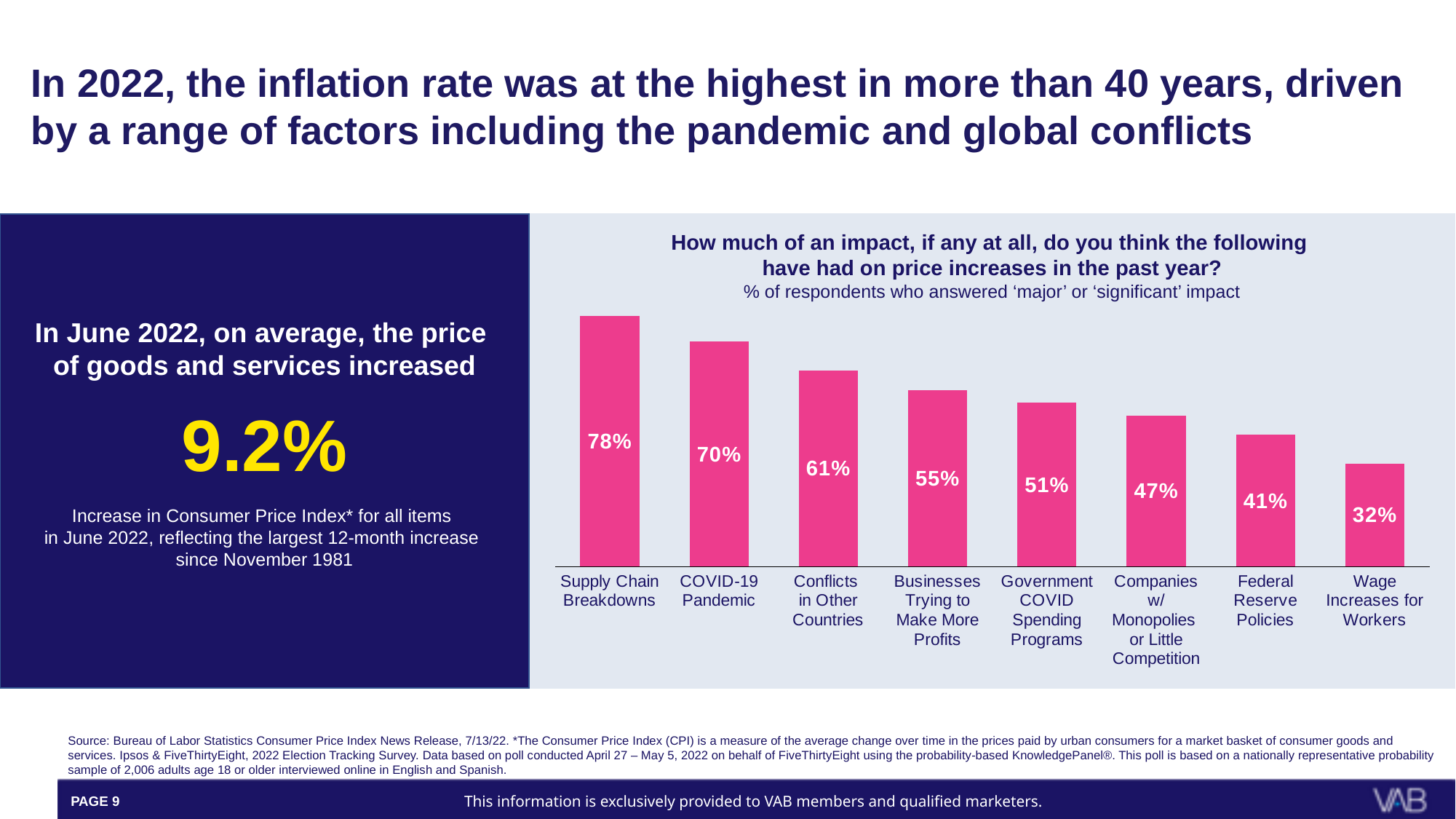
What type of chart is used to show the impact of factors on price increases? Bar chart Do the values rise or fall moving from left to right across the chart? Fall Which factor has the lowest percentage in the chart? Wage Increases for Workers What is the difference between the highest and lowest values in the chart? 46 percentage points What is the difference in percentage points between COVID-19 Pandemic and Conflicts in Other Countries? 9 percentage points What is the value shown for Federal Reserve Policies? 41% What percentage of respondents said Supply Chain Breakdowns had a major or significant impact on price increases? 78% Which factor has the highest percentage of respondents citing a major or significant impact? Supply Chain Breakdowns What is the value shown for Government COVID Spending Programs? 51% What does the chart subtitle say the percentages represent? % of respondents who answered 'major' or 'significant' impact How many factors are shown in the bar chart? 8 Which has a higher value: Businesses Trying to Make More Profits or Companies w/ Monopolies or Little Competition? Businesses Trying to Make More Profits